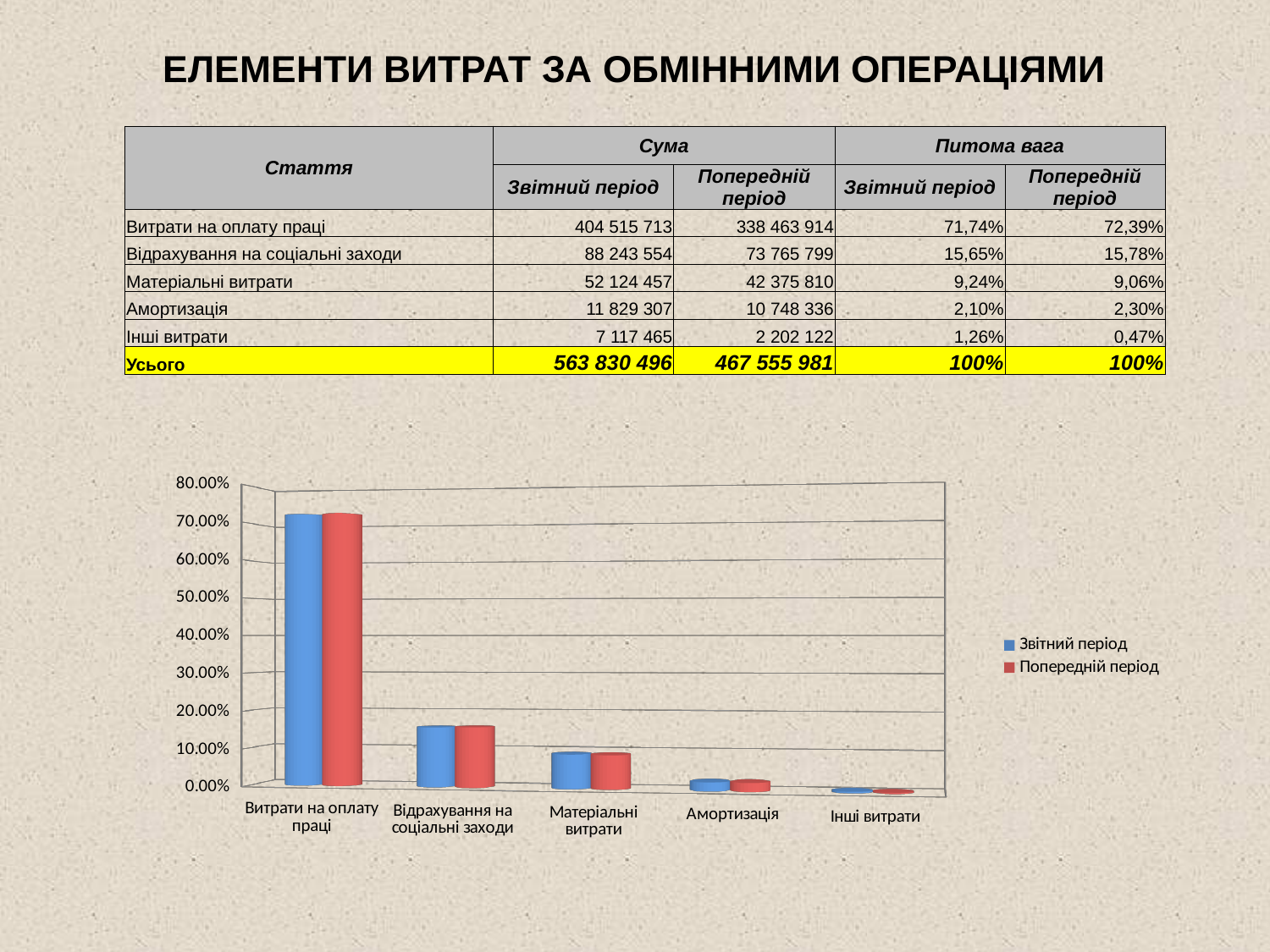
Which category has the lowest value for Попередній період in the chart? Інші витрати How many categories are shown along the x axis of the chart? 5 Is the Звітний період value for Витрати на оплату праці greater or less than 60.00%? greater For Звітний період, which is larger: Відрахування на соціальні заходи or Матеріальні витрати? Відрахування на соціальні заходи What is the difference between the Звітний період and Попередній період shares for Інші витрати? 0,79% What is the Попередній період share for Амортизація? 2,30% Do the Звітний період values rise or fall from left to right along the x axis? fall What kind of chart is shown on the slide? bar chart Which category has the highest value for Звітний період in the chart? Витрати на оплату праці Is the Попередній період value for Відрахування на соціальні заходи greater or less than 20.00%? less What is the Звітний період share for Матеріальні витрати? 9,24% How many series does the chart legend list? 2